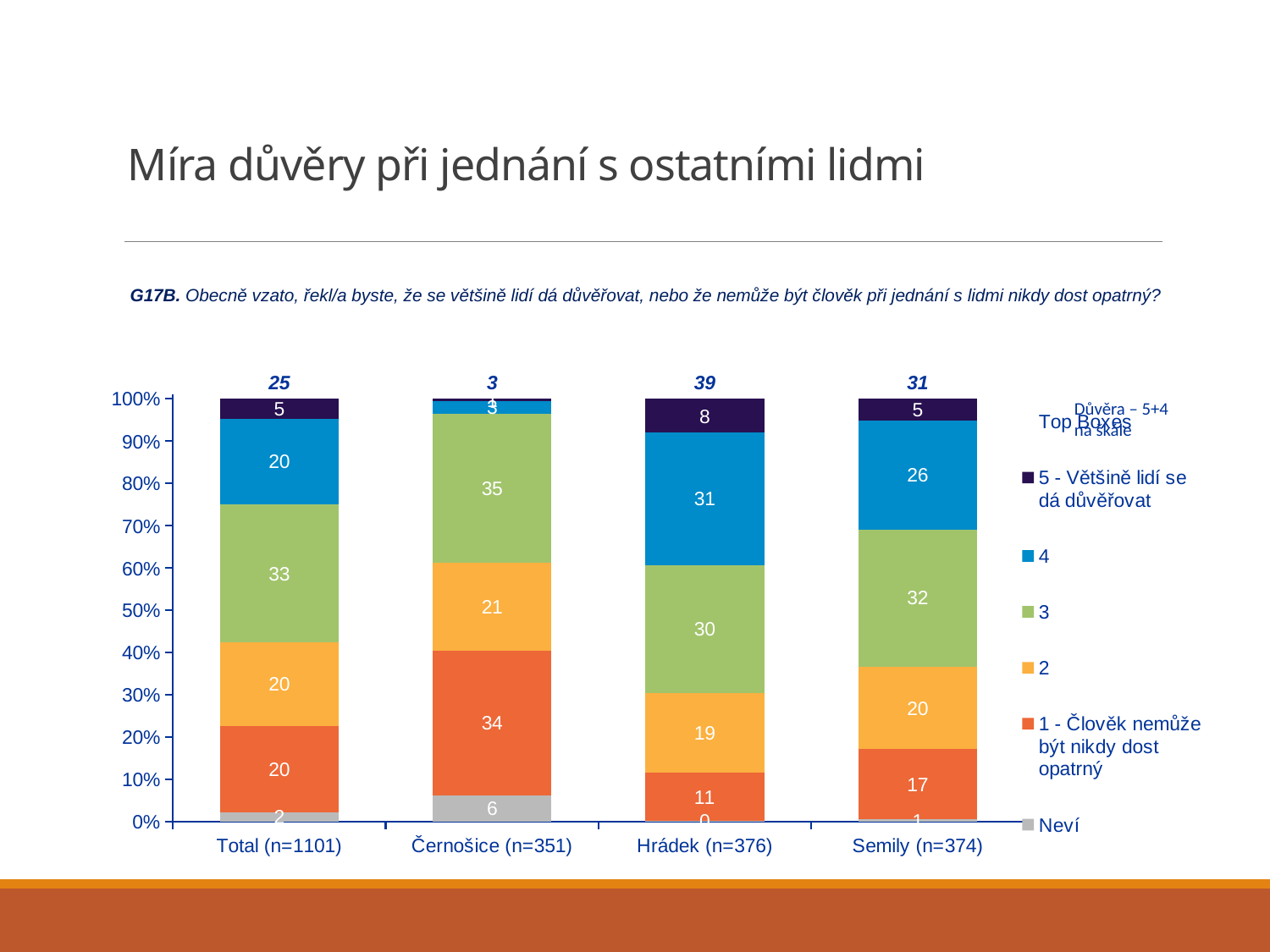
What is the value for series 4 in the Hrádek (n=376) bar? 31 What is the difference between the '1 - Člověk nemůže být nikdy dost opatrný' values for Černošice (n=351) and Hrádek (n=376)? 23 What is the value for '1 - Člověk nemůže být nikdy dost opatrný' in the Semily (n=374) bar? 17 How many series does the legend list? 7 How many categories are shown on the x axis? 4 Which category has the lowest Top Boxes value shown above the bars? Černošice (n=351) What is the value for series 3 in the Černošice (n=351) bar? 35 Which is larger: the series 4 value for Total (n=1101) or for Semily (n=374)? Semily (n=374) Which legend entry is shown in green? 3 Which category has the highest Top Boxes value shown above the bars? Hrádek (n=376) What is the Top Boxes value shown above the Hrádek (n=376) bar? 39 What kind of chart is shown on the slide? Stacked bar chart